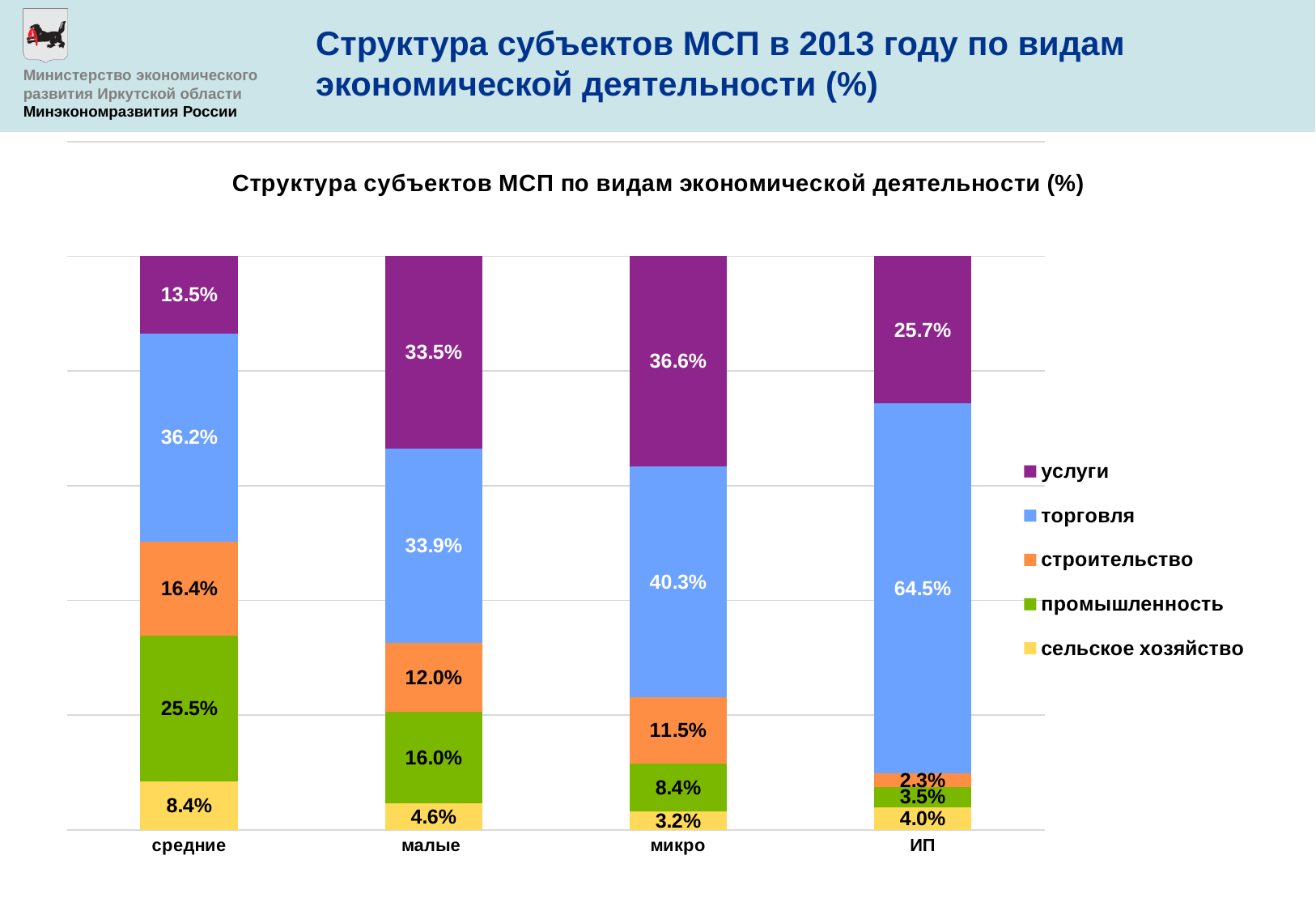
What is the value for строительство in the микро bar? 11.5% Which legend entry is shown in purple? услуги Which category has the lowest value for сельское хозяйство? микро What is the value for торговля in the ИП bar? 64.5% What is the difference between the торговля values for ИП and средние? 28.3% How many series does the legend list? 5 Which category has the highest value for торговля? ИП What kind of chart is shown on the slide? stacked bar chart Which is larger: услуги for малые or услуги for микро? микро How many categories are shown on the x axis? 4 What is the value for промышленность in the средние bar? 25.5% What is the value for сельское хозяйство in the малые bar? 4.6%